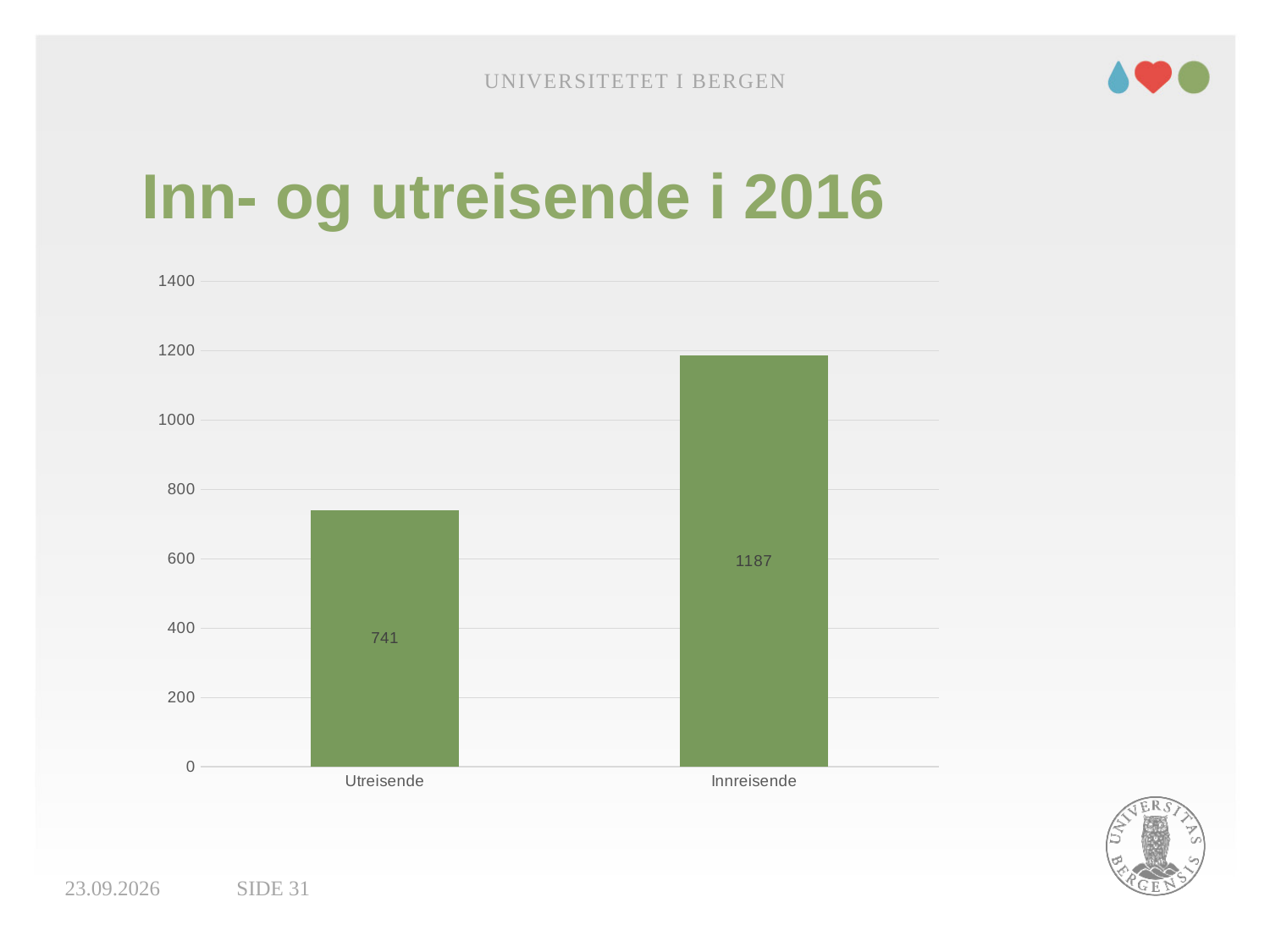
Is the value for Innreisende greater or less than 1000? greater What kind of chart is shown on the slide? bar chart What is the value for Innreisende? 1187 Which category has the lowest value? Utreisende What is the title of the slide containing the chart? Inn- og utreisende i 2016 Is the value for Utreisende greater or less than 800? less Which category has the highest value? Innreisende What is the difference between the values for Innreisende and Utreisende? 446 What is the value for Utreisende? 741 How many categories are shown on the x axis? 2 Which is larger, the value for Utreisende or the value for Innreisende? Innreisende What is the highest value shown on the y axis? 1400